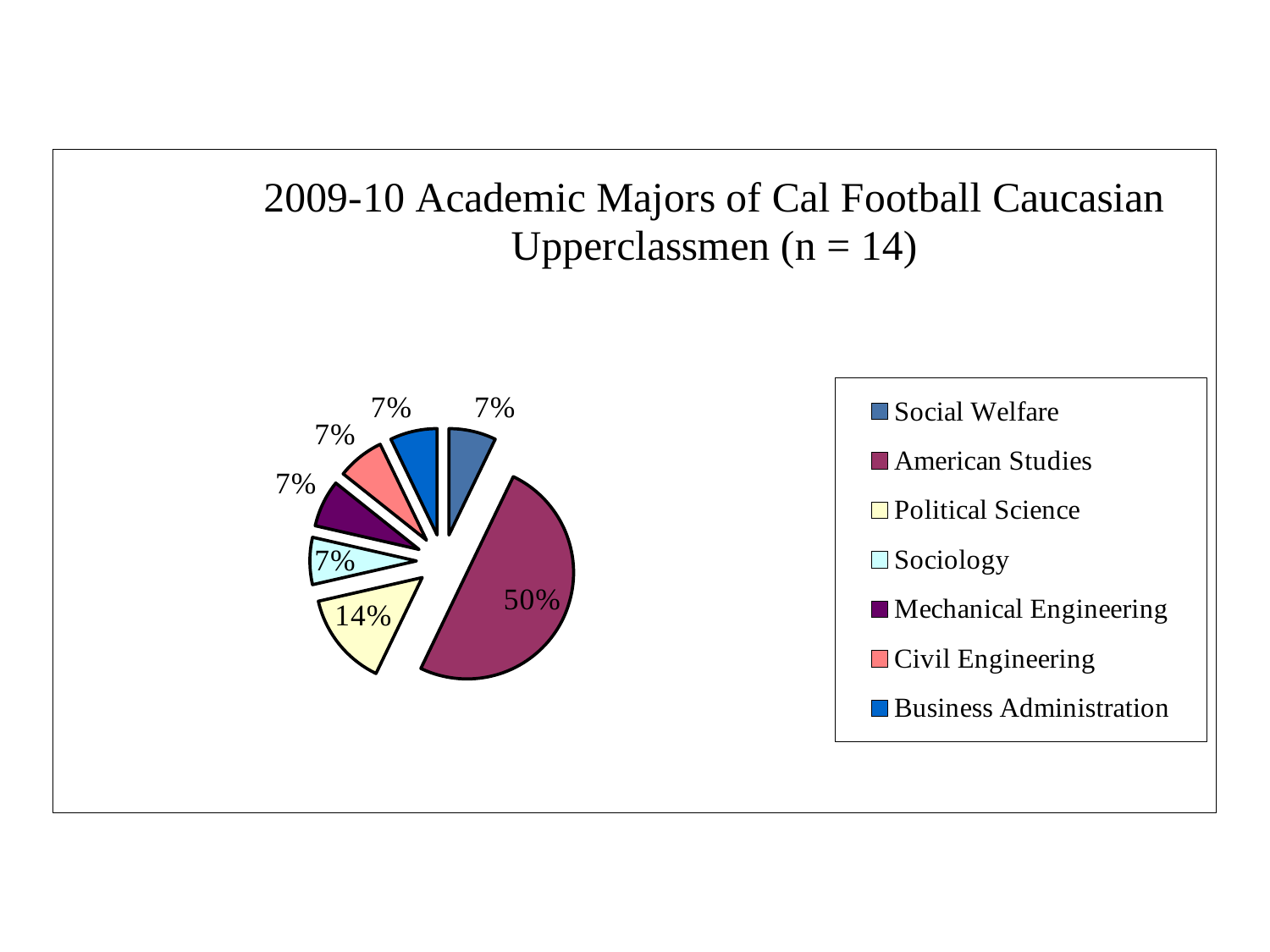
Which major has the largest slice of the pie? American Studies What share of the pie does Political Science represent? 14% How many categories does the legend list? 7 Which is larger, the share for Political Science or the share for Mechanical Engineering? Political Science What is the title of the chart? 2009-10 Academic Majors of Cal Football Caucasian Upperclassmen (n = 14) What is the difference between the share for American Studies and the share for Political Science? 36% What share of the pie does Business Administration represent? 7% What share of the pie does American Studies represent? 50% How many majors each account for 7% of the pie? 5 What colour is the slice for American Studies? Maroon What kind of chart is shown on the slide? Pie chart